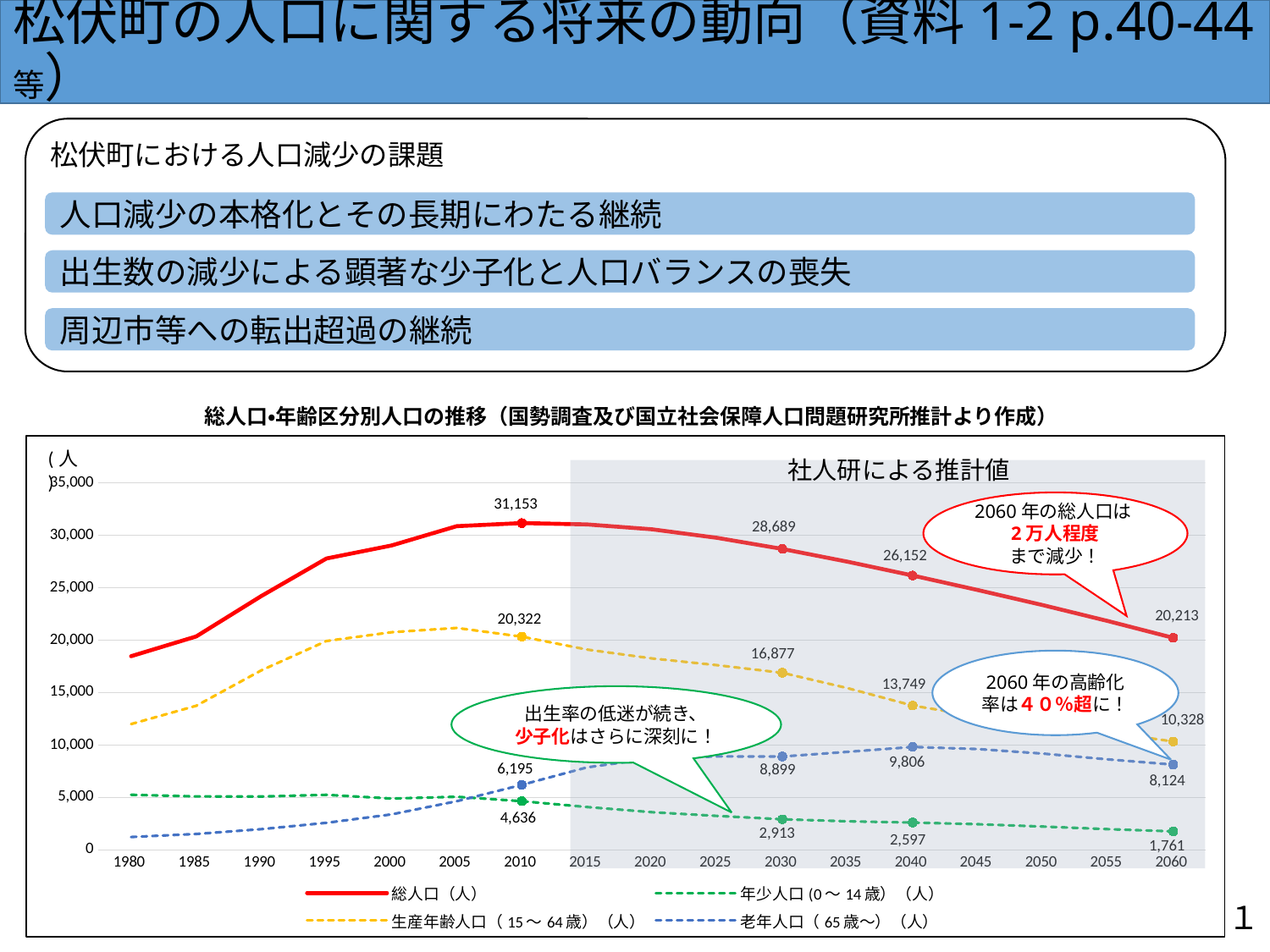
By how much does 総人口（人） decrease from 2010 to 2060? 10,940 How many series does the legend list? 4 What is the value of 生産年齢人口（15～64歳）（人） in 2040? 13,749 What is the value of 老年人口（65歳～）（人） in 2030? 8,899 What type of chart is shown on the slide? line chart Is the value of 総人口（人） in 1980 greater or less than 20,000? less What is the value of 総人口（人） in 2060? 20,213 What is the value of 年少人口(0～14歳)（人） in 2060? 1,761 What is the difference between 老年人口（65歳～）（人） and 年少人口(0～14歳)（人） in 2040? 7,209 Does 年少人口(0～14歳)（人） rise or fall from 2010 to 2060? fall What is the value of 総人口（人） in 2010? 31,153 In 2060, which is larger: 生産年齢人口（15～64歳）（人） or 老年人口（65歳～）（人）? 生産年齢人口（15～64歳）（人）